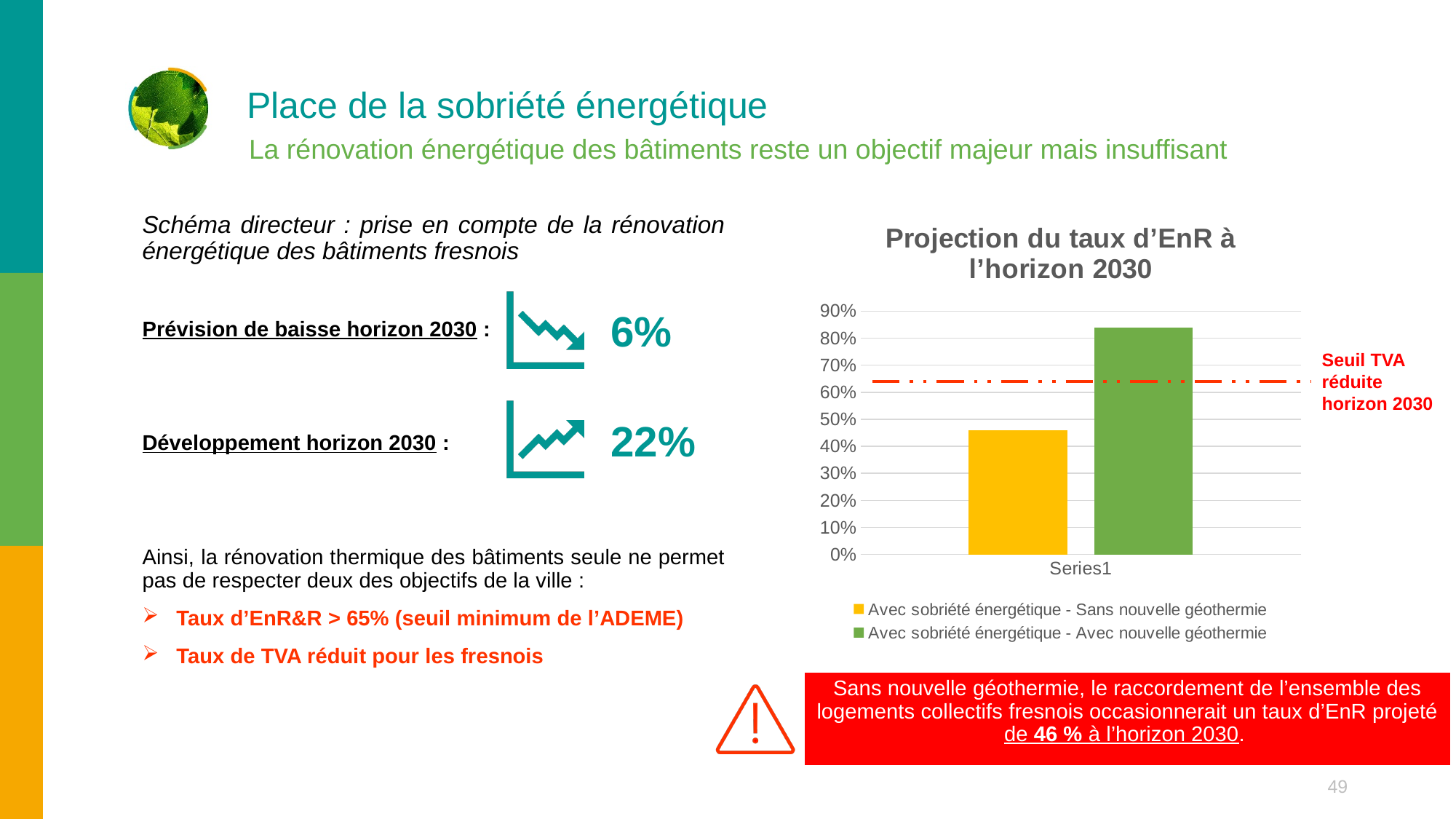
In the "Projection du taux d'EnR à l'horizon 2030" chart, is the bar for "Avec nouvelle géothermie" larger or smaller than the bar for "Sans nouvelle géothermie"? larger In the "Projection du taux d'EnR à l'horizon 2030" chart, what label is given to the dashed red horizontal line? Seuil TVA réduite horizon 2030 In the "Projection du taux d'EnR à l'horizon 2030" chart, is the value for "Avec sobriété énergétique - Avec nouvelle géothermie" greater or less than 90%? less In the "Projection du taux d'EnR à l'horizon 2030" chart, is the dashed red line greater or less than 60%? greater What is the title of the chart on the right of the slide? Projection du taux d'EnR à l'horizon 2030 In the "Projection du taux d'EnR à l'horizon 2030" chart, which series has the highest bar? Avec sobriété énergétique - Avec nouvelle géothermie In the "Projection du taux d'EnR à l'horizon 2030" chart, is the value for "Avec sobriété énergétique - Avec nouvelle géothermie" greater or less than 80%? greater What kind of chart is shown under the title "Projection du taux d'EnR à l'horizon 2030"? bar chart How many series does the legend of the "Projection du taux d'EnR à l'horizon 2030" chart list? 2 In the "Projection du taux d'EnR à l'horizon 2030" chart, which series has the lowest bar? Avec sobriété énergétique - Sans nouvelle géothermie